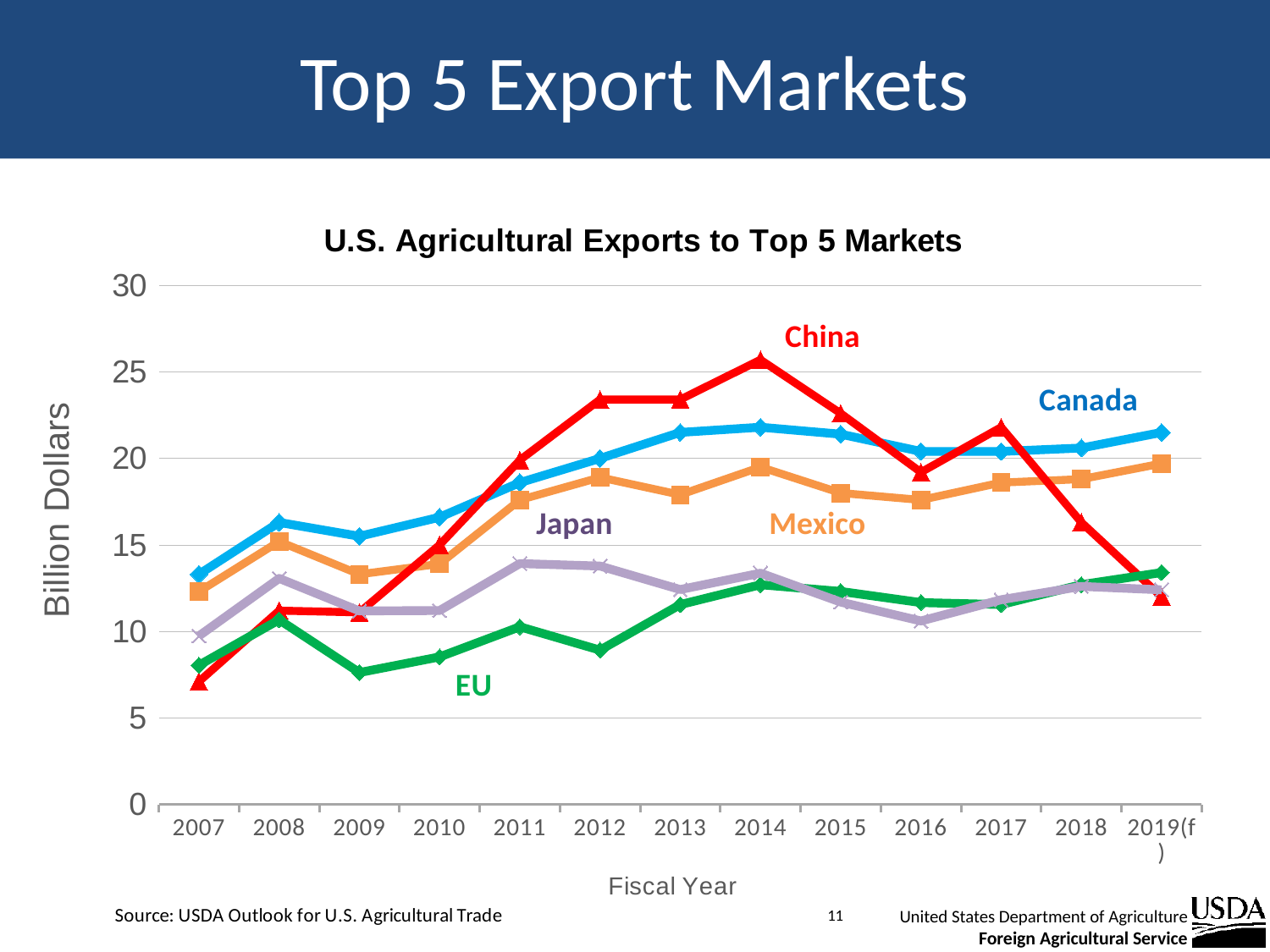
Do exports to China rise or fall from 2014 to 2019(f)? fall Is the value for the EU in 2009 greater or less than 10? less Is the value for China in 2014 greater or less than 25? greater How many fiscal years are shown along the x axis? 13 What is the label on the vertical axis of the chart? Billion Dollars In 2019(f), which is larger: exports to China or exports to Canada? Canada How many export markets (series) are plotted on the chart? 5 Is the value for Mexico in 2009 greater or less than 15? less Which market had the lowest exports in 2010? EU Which market had the highest exports in 2014? China What kind of chart is shown on the slide? line chart